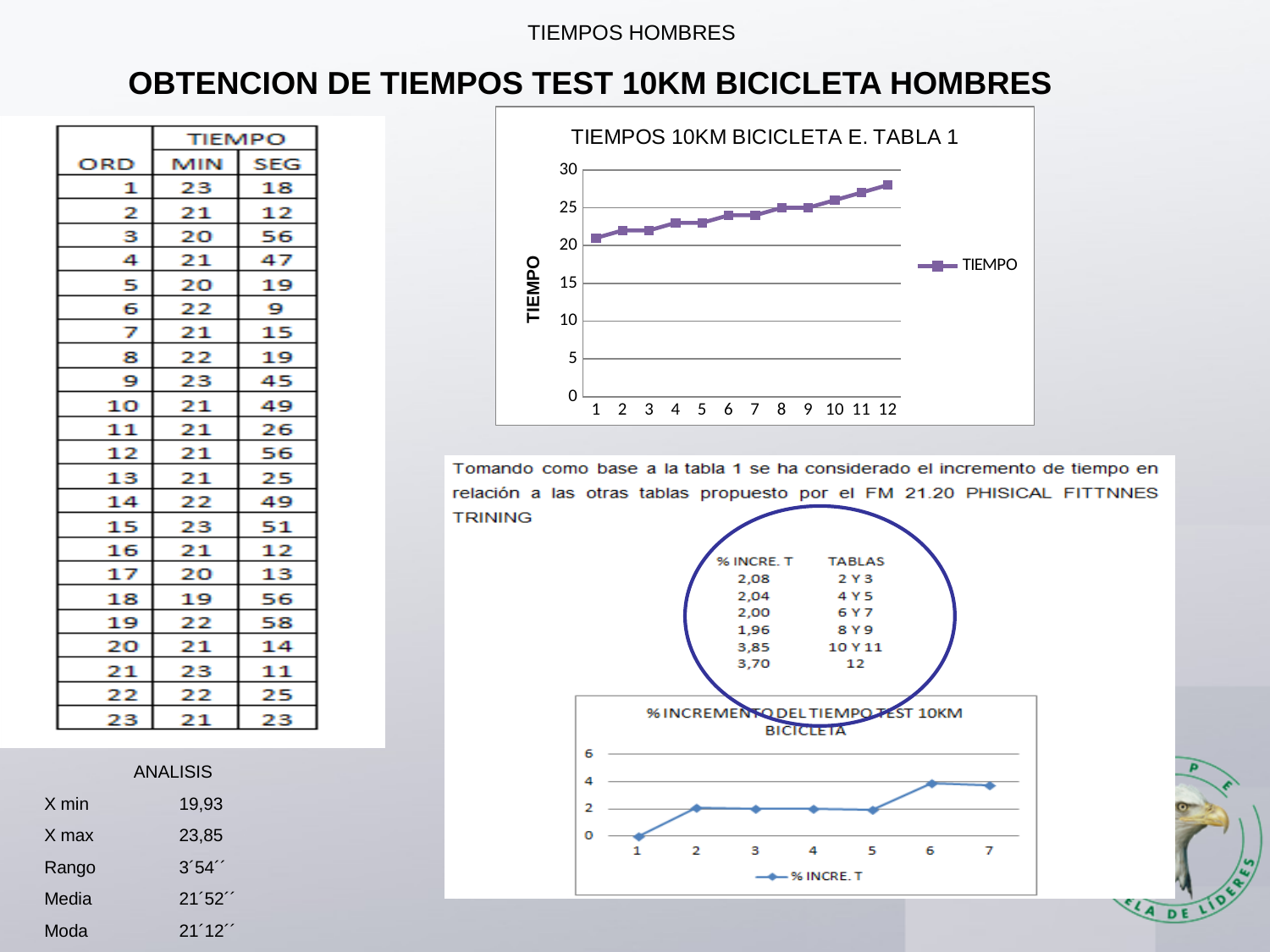
What type of chart is the chart titled "TIEMPOS 10KM BICICLETA E. TABLA 1"? line chart In the chart titled "TIEMPOS 10KM BICICLETA E. TABLA 1", which point has the highest value, point 1 or point 12? point 12 In the chart titled "TIEMPOS 10KM BICICLETA E. TABLA 1", do the values rise or fall from point 1 to point 12? rise In the chart titled "TIEMPOS 10KM BICICLETA E. TABLA 1", is the value at point 1 greater or less than 25? less In the chart titled "TIEMPOS 10KM BICICLETA E. TABLA 1", is the value at point 12 greater or less than 25? greater In the chart titled "% INCREMENTO DEL TIEMPO TEST 10KM BICICLETA", is the value at point 6 greater or less than 2? greater In the chart titled "% INCREMENTO DEL TIEMPO TEST 10KM BICICLETA", how many points are plotted along the x axis? 7 What is the name of the series shown in the legend of the chart titled "% INCREMENTO DEL TIEMPO TEST 10KM BICICLETA"? % INCRE. T What is the name of the series shown in the legend of the chart titled "TIEMPOS 10KM BICICLETA E. TABLA 1"? TIEMPO In the chart titled "TIEMPOS 10KM BICICLETA E. TABLA 1", how many points are plotted along the x axis? 12 In the chart titled "TIEMPOS 10KM BICICLETA E. TABLA 1", how many series does the legend list? 1 In the chart titled "% INCREMENTO DEL TIEMPO TEST 10KM BICICLETA", which point has the lowest value? 1